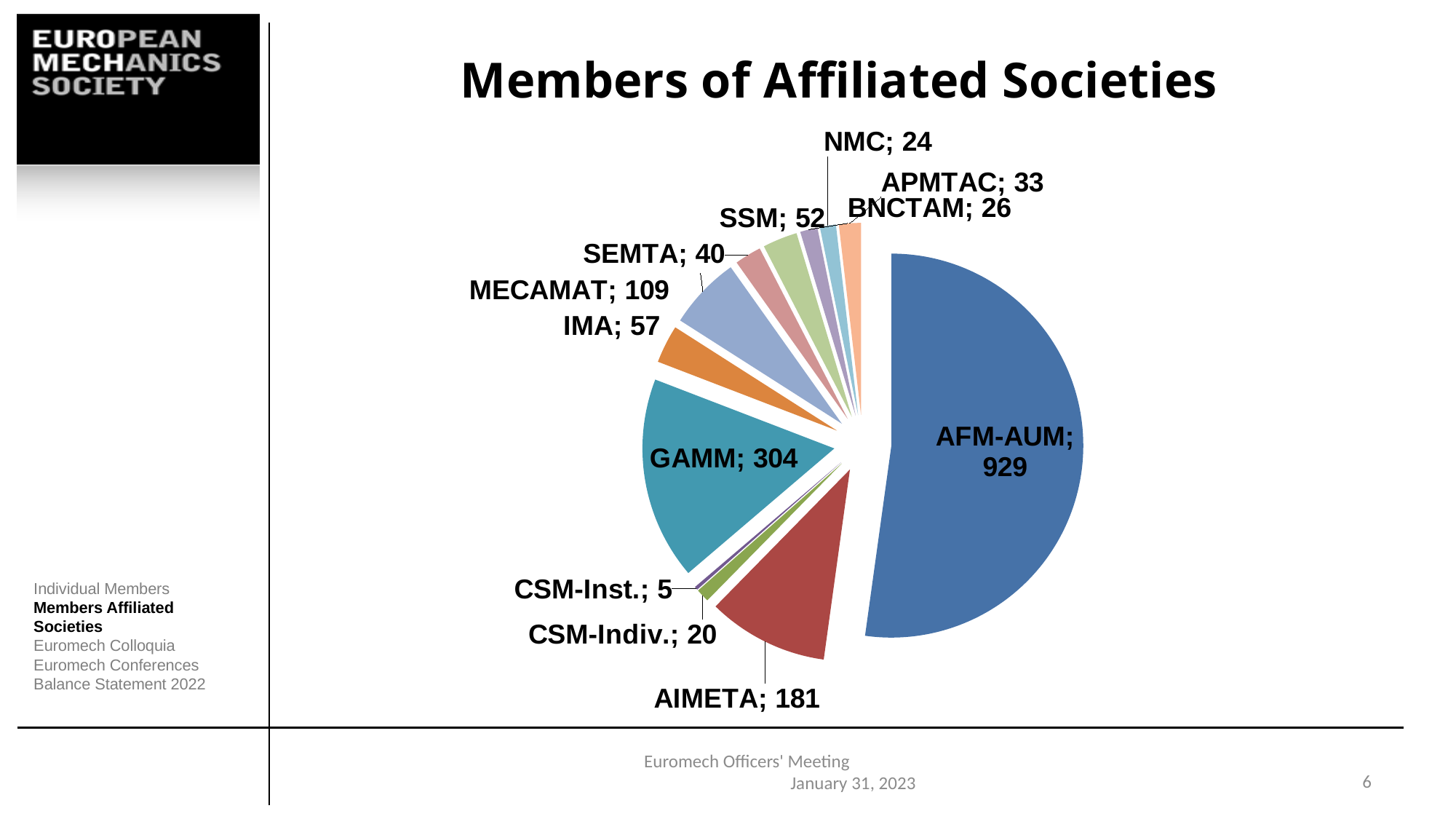
What is the title of the chart? Members of Affiliated Societies Which is larger, the value for SSM or the value for SEMTA? SSM What is the difference between the values for MECAMAT and IMA? 52 How many slices does the pie chart have? 12 What is the difference between the values for GAMM and AIMETA? 123 How many members does AFM-AUM have? 929 Which society has the largest slice of the pie? AFM-AUM What is the value shown for MECAMAT? 109 Which society has the smallest slice of the pie? CSM-Inst. What kind of chart is shown on the slide? pie chart What is the value shown for CSM-Inst.? 5 What is the value shown for GAMM? 304